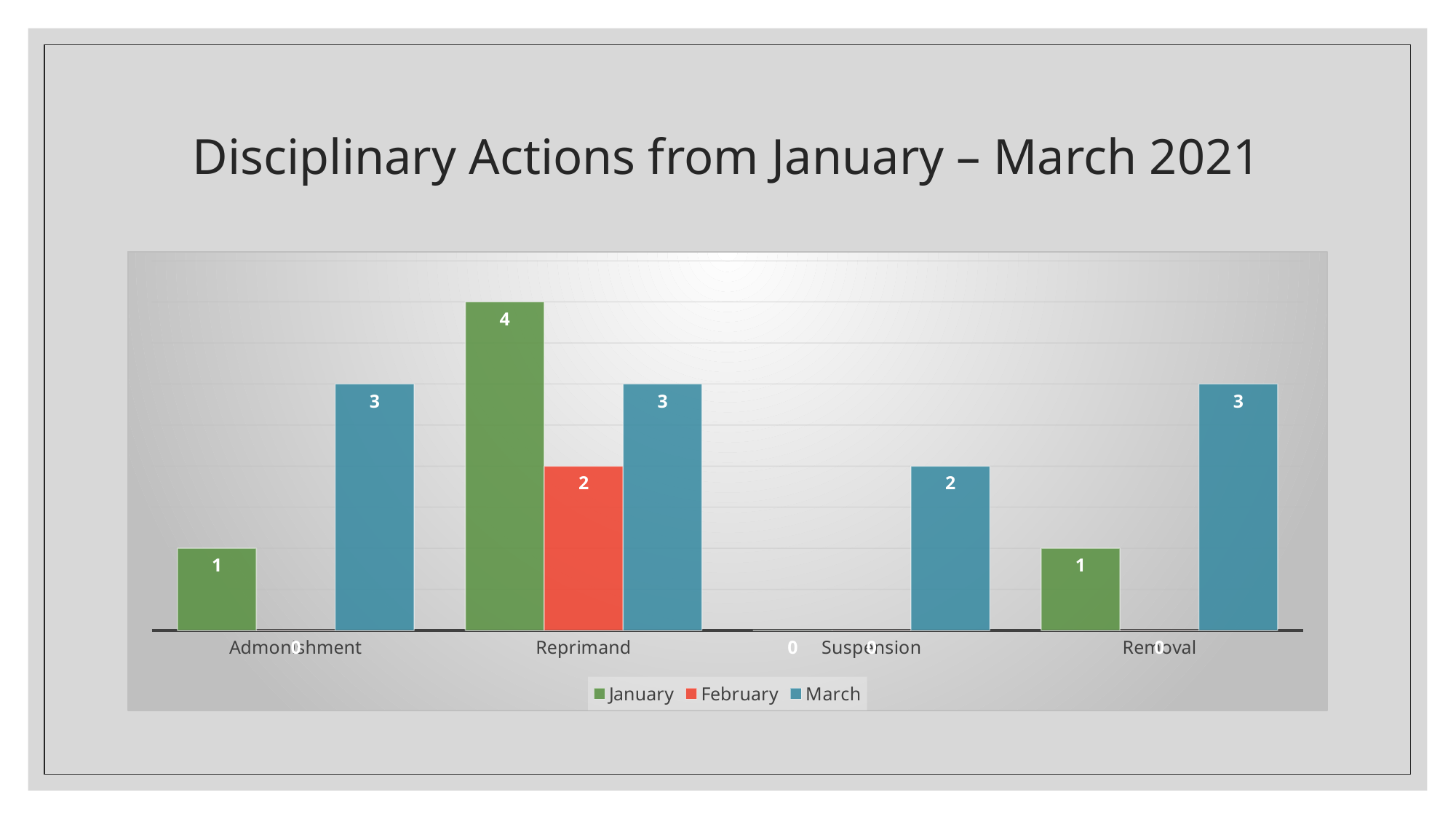
What is the value for February in the Reprimand category? 2 What is the difference between the January and March values for Reprimand? 1 What is the value for March in the Suspension category? 2 What is the value for January in the Reprimand category? 4 What is the value for March in the Admonishment category? 3 Which is larger: the March value for Admonishment or the March value for Suspension? Admonishment What kind of chart is shown on the slide? Bar chart Which category has the highest January value? Reprimand How many series does the legend list? 3 Which category has the lowest March value? Suspension How many categories are shown on the x axis? 4 What is the value for January in the Removal category? 1